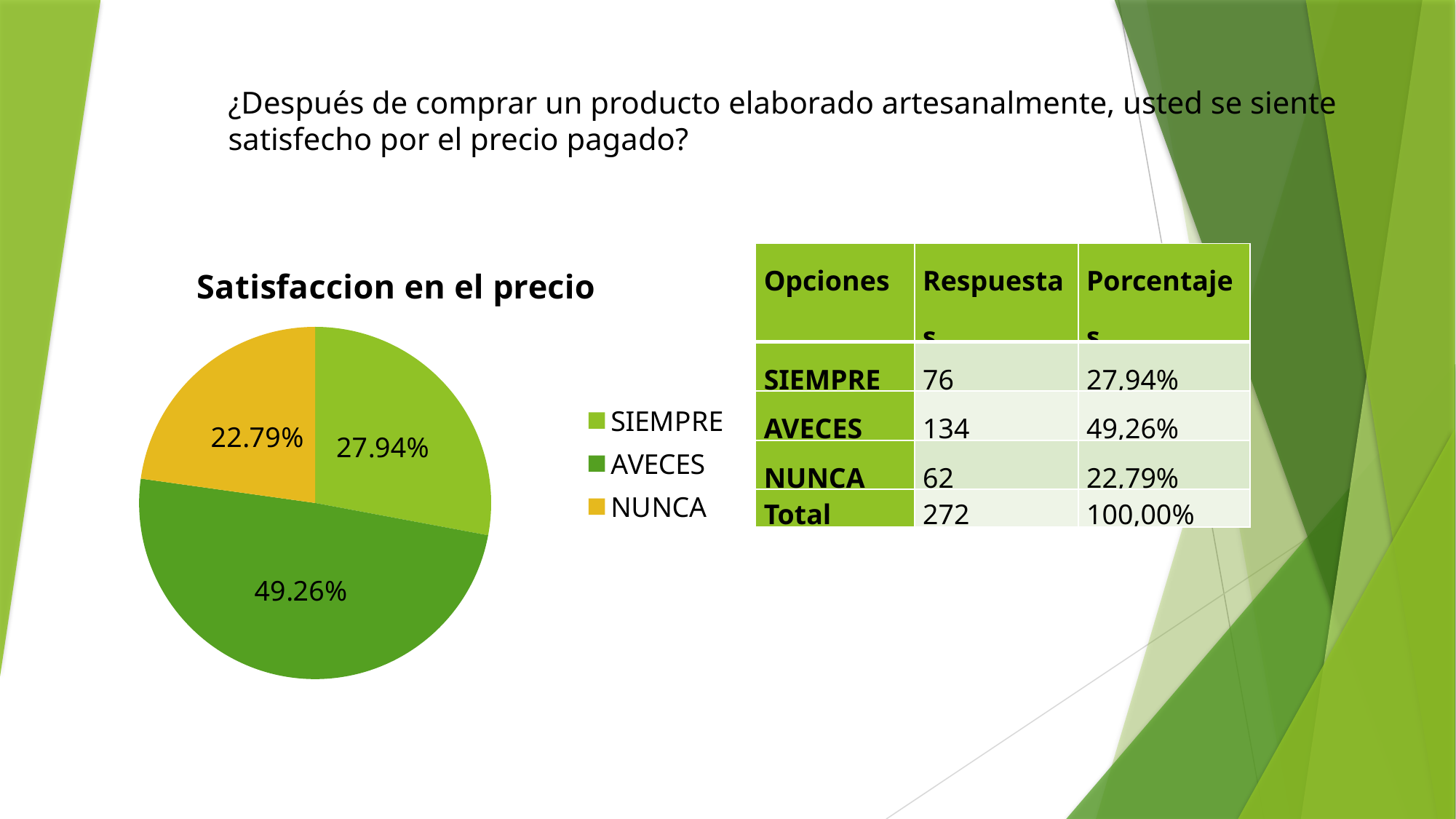
What type of chart is shown on the slide? pie chart Which category has the largest share of the pie? AVECES What percentage does the SIEMPRE slice show? 27.94% How many slices does the pie chart have? 3 What is the difference in percentage points between the AVECES and SIEMPRE slices? 21.32 What is the title of the chart? Satisfaccion en el precio How many entries does the legend list? 3 What percentage does the NUNCA slice show? 22.79% Which is larger, the SIEMPRE slice or the NUNCA slice? SIEMPRE What colour is the NUNCA slice? yellow What percentage does the AVECES slice show? 49.26% Which category has the smallest share of the pie? NUNCA